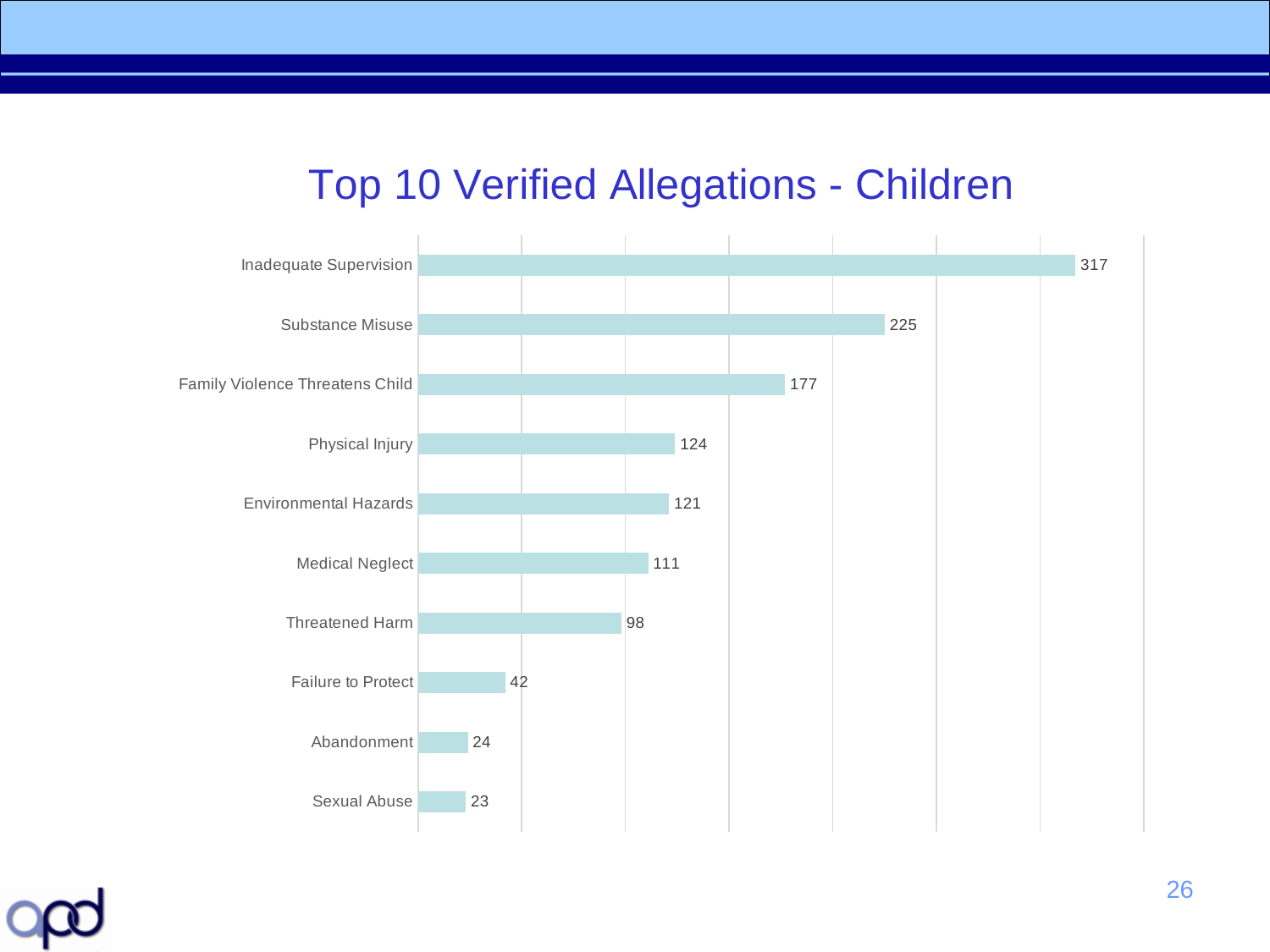
Which is larger, Physical Injury or Environmental Hazards? Physical Injury What is the difference between Substance Misuse and Family Violence Threatens Child? 48 How many categories are shown in the chart? 10 What is the value for Abandonment? 24 What is the title of the chart? Top 10 Verified Allegations - Children What is the difference between Threatened Harm and Failure to Protect? 56 Which is larger, Substance Misuse or Medical Neglect? Substance Misuse What kind of chart is this? Bar chart What is the value for Inadequate Supervision? 317 What is the value for Medical Neglect? 111 Which category has the highest value? Inadequate Supervision Which category has the lowest value? Sexual Abuse